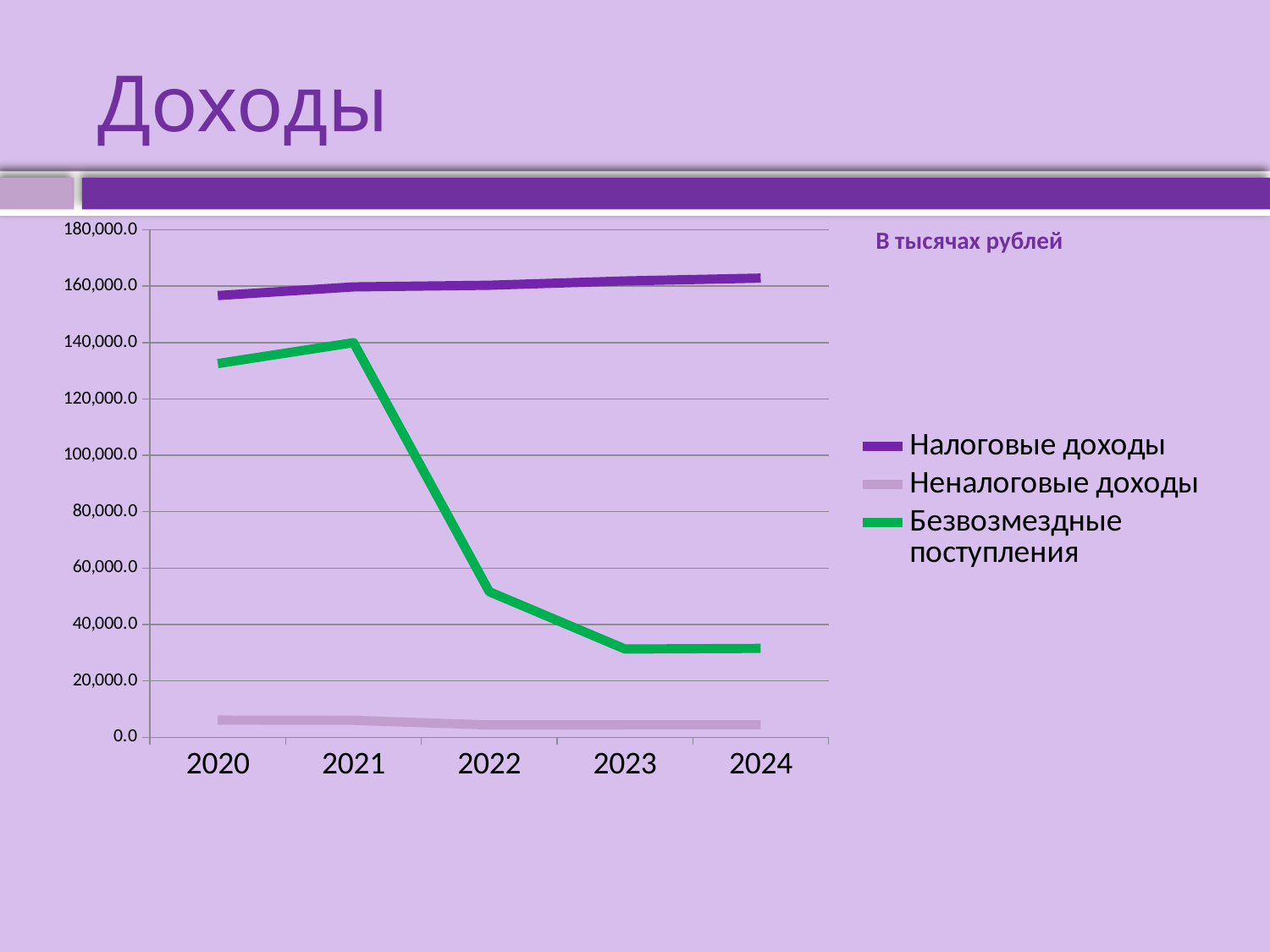
How many series does the legend list? 3 What kind of chart is shown on the slide? line chart Is the value for Безвозмездные поступления in 2023 greater or less than 40,000.0? less Does the line for Налоговые доходы rise or fall from 2020 to 2024? rise In which year is Безвозмездные поступления at its highest? 2021 In 2022, which is larger: Налоговые доходы or Безвозмездные поступления? Налоговые доходы What unit note is printed next to the chart? В тысячах рублей Is the value for Налоговые доходы in 2020 greater or less than 140,000.0? greater Is the value for Безвозмездные поступления in 2021 greater or less than 120,000.0? greater How many years are shown on the x axis? 5 Does the line for Безвозмездные поступления rise or fall from 2021 to 2024? fall